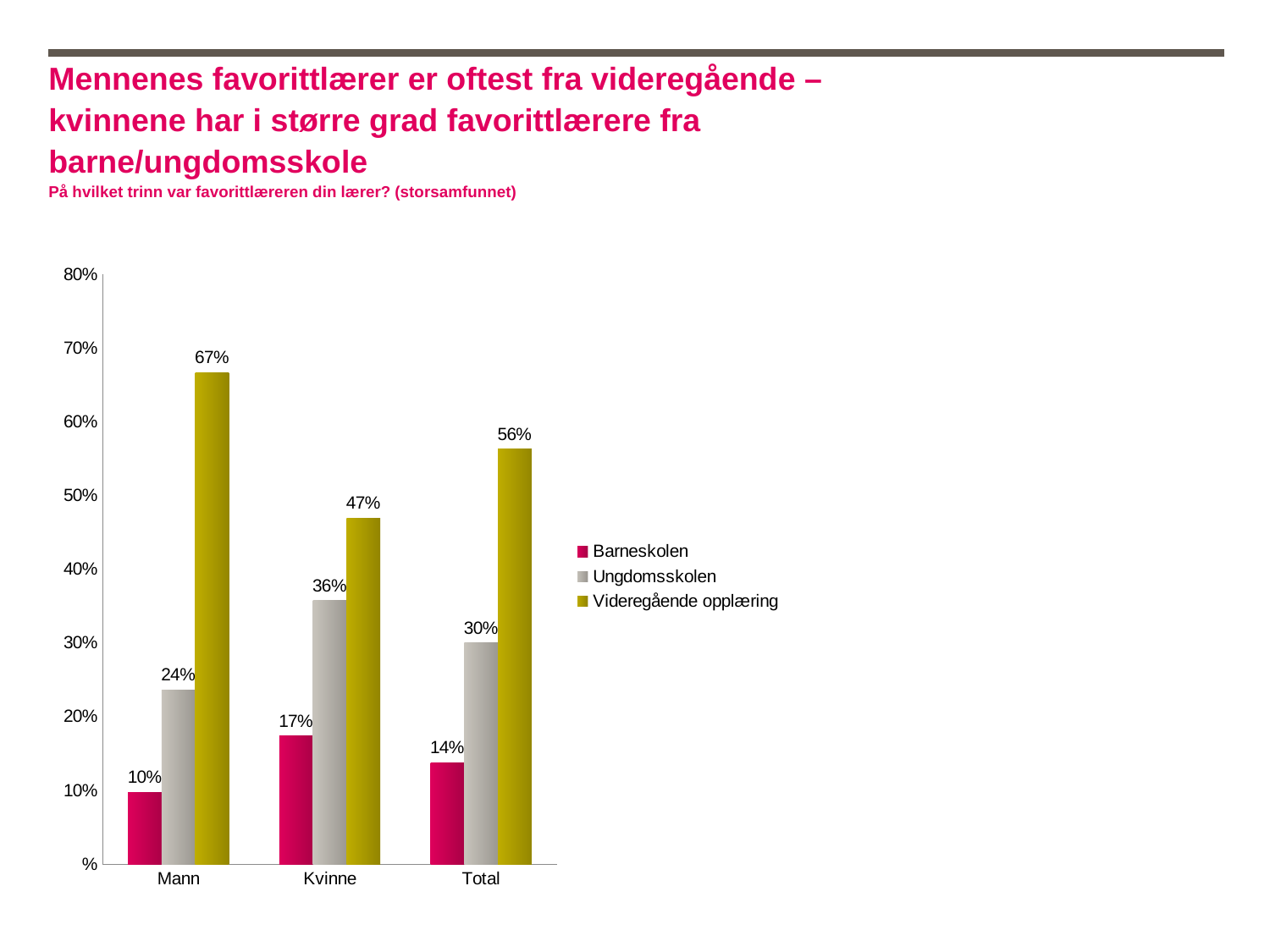
What is the difference between the Videregående opplæring values for Mann and Kvinne? 20% What is the value for Videregående opplæring in the Mann category? 67% How many categories are shown on the x axis? 3 Which category has the lowest value for Barneskolen? Mann How many series does the legend list? 3 What is the difference between the Barneskolen values for Kvinne and Mann? 7% What kind of chart is shown on the slide? Bar chart What is the value for Ungdomsskolen in the Total category? 30% What is the value for Barneskolen in the Kvinne category? 17% Which is larger: Ungdomsskolen for Kvinne or Ungdomsskolen for Mann? Kvinne Which legend entry is shown in yellow-green? Videregående opplæring Which category has the highest value for Videregående opplæring? Mann